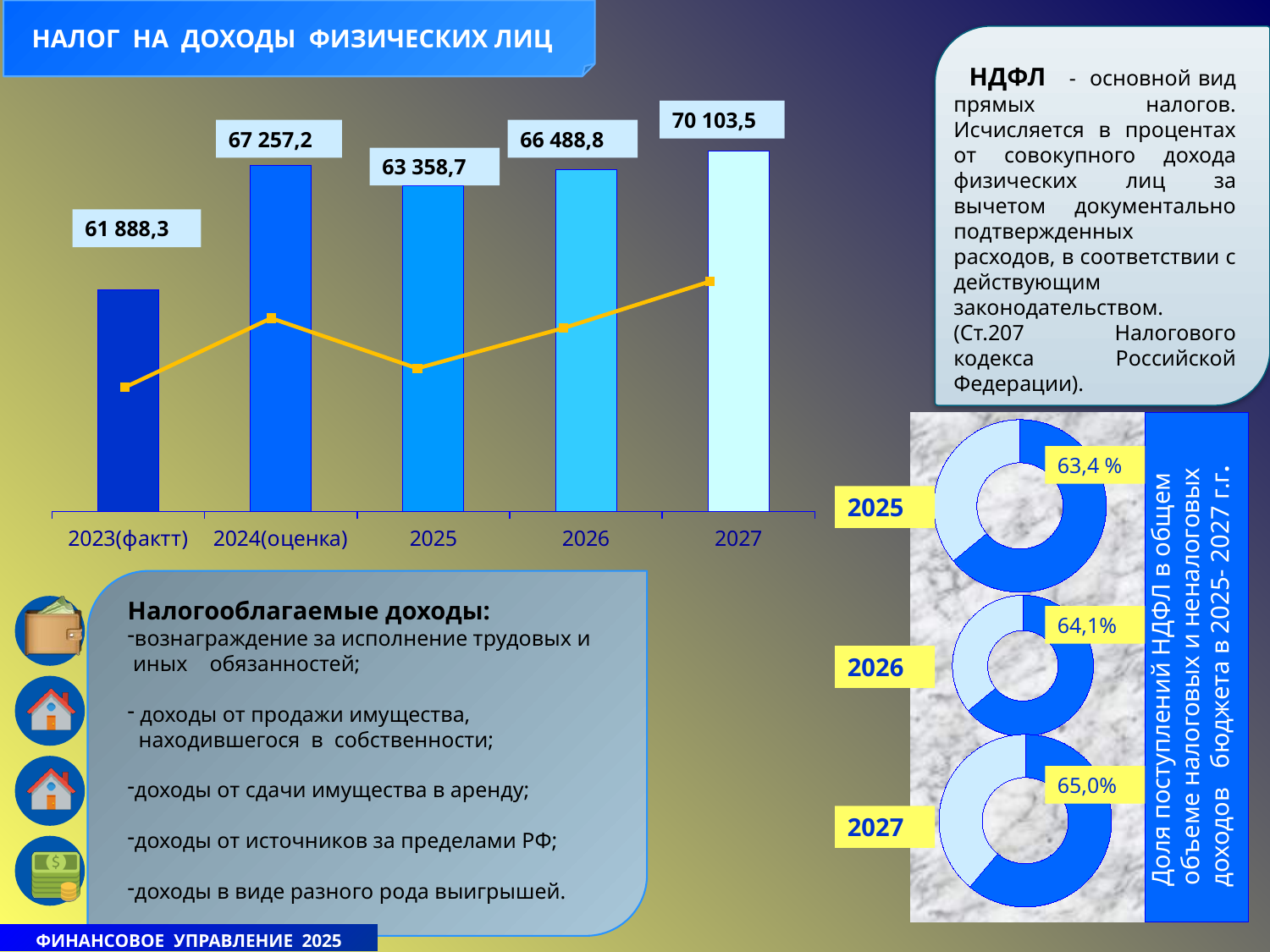
In the bar chart, which category has the highest value? 2027 In the bar chart, what is the difference between the values for 2027 and 2023(факт)? 8 215,2 In the donut charts on the right, what share is shown for 2025? 63,4 % What kind of chart is the large chart on the left of the slide? bar chart with a line overlay In the bar chart, what is the value for 2024(оценка)? 67 257,2 In the bar chart, what is the value for 2023(факт)? 61 888,3 In the donut charts on the right, what share is shown for 2027? 65,0% In the bar chart, what is the difference between the values for 2024(оценка) and 2025? 3 898,5 How many categories are shown on the x axis of the bar chart? 5 In the bar chart, which is larger: the value for 2025 or the value for 2026? 2026 In the bar chart, which category has the lowest value? 2023(факт) In the bar chart, what is the value for 2027? 70 103,5